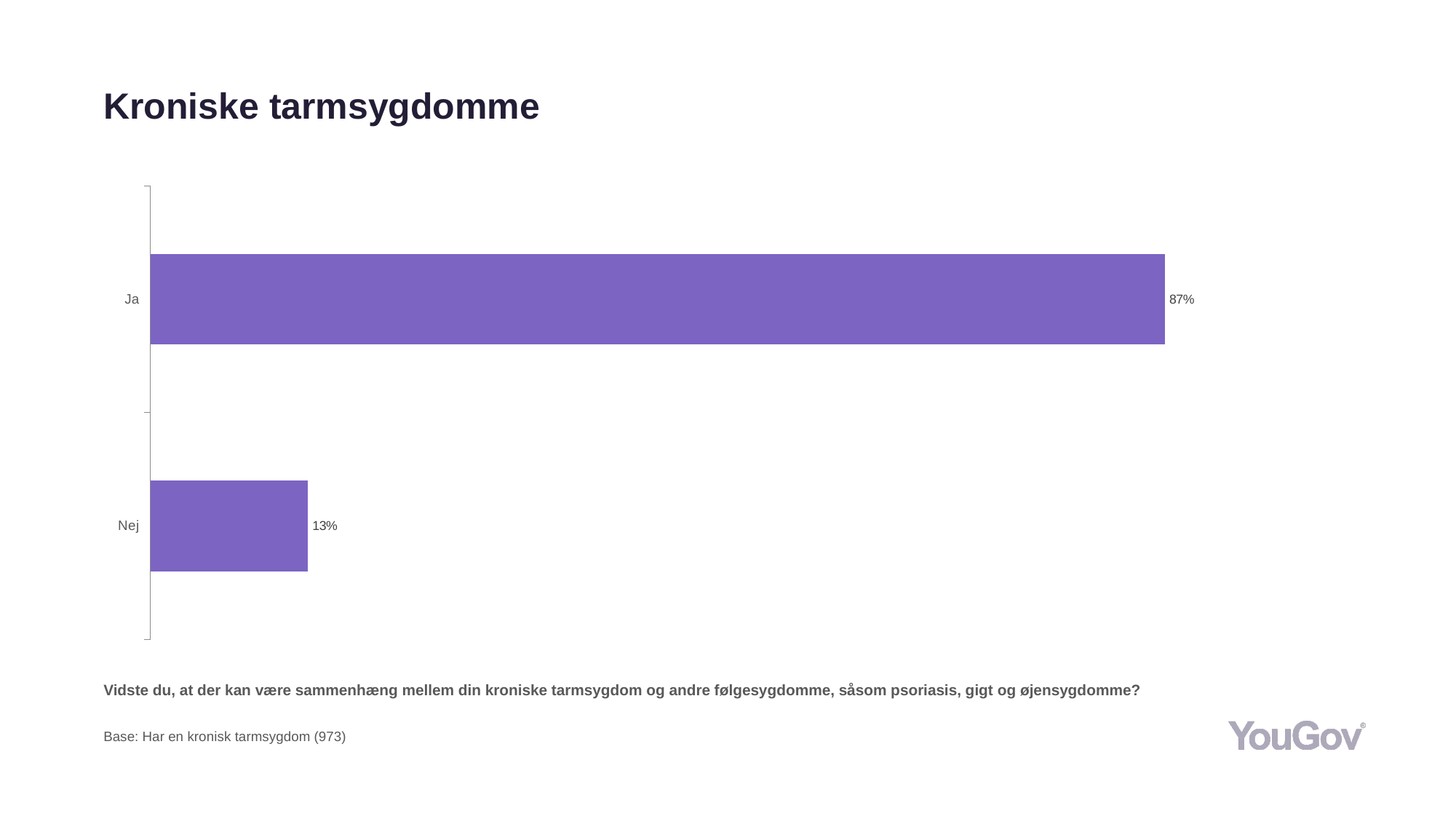
How many categories are shown in the chart? 2 What is the base size stated below the chart? 973 What is the value for Nej? 13% What kind of chart is shown on the slide? Bar chart What is the value for Ja? 87% Which category has the lowest value? Nej Which category has the highest value? Ja What is the difference between the values for Ja and Nej? 74% What is the title of the slide? Kroniske tarmsygdomme What is the total of the values for Ja and Nej? 100% Which is larger, the value for Ja or the value for Nej? Ja